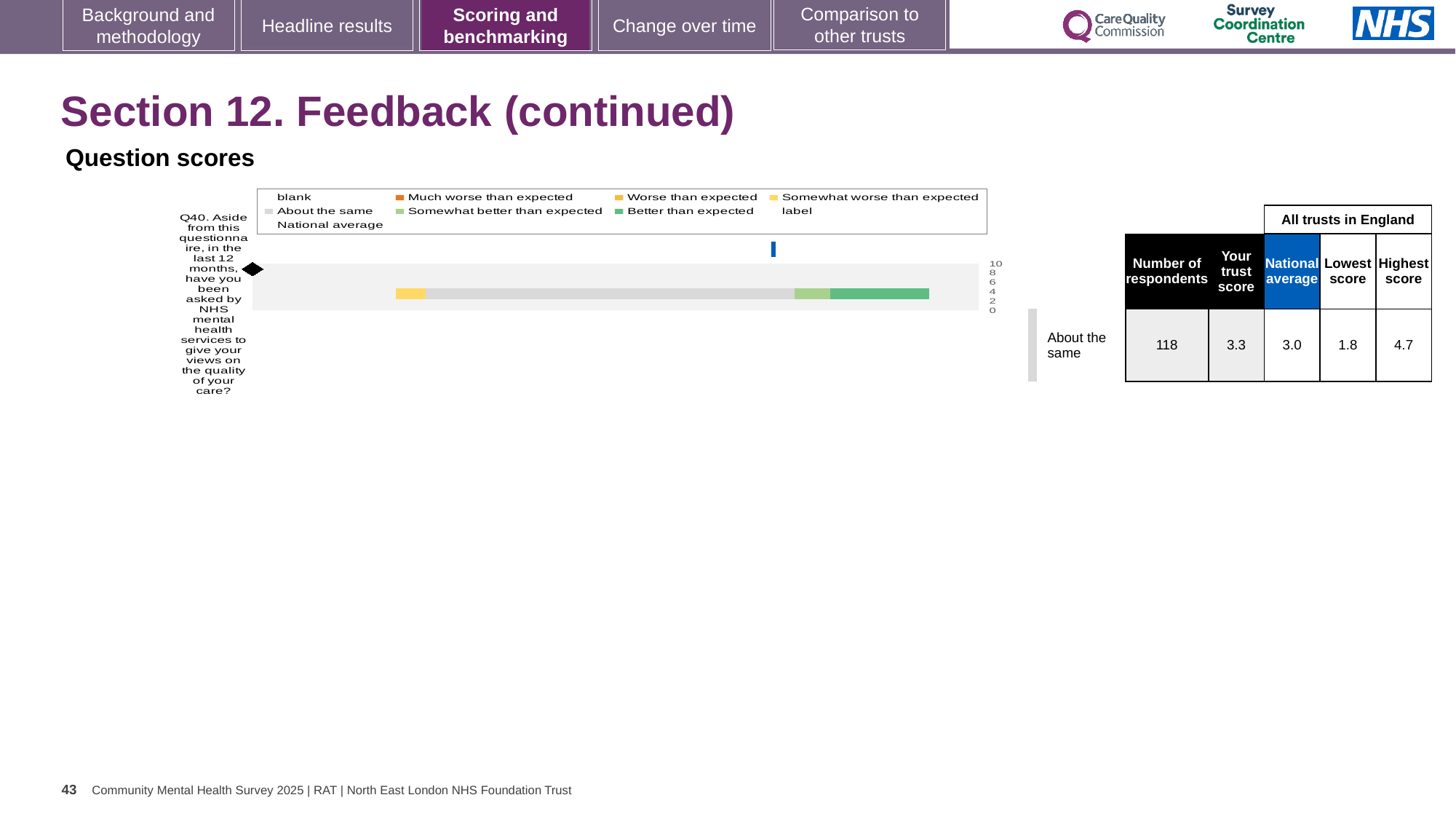
Which legend entry is shown in orange? Much worse than expected Is the trust's score for Q40 higher or lower than the national average? higher What benchmark category is shown for Q40 next to the chart? About the same In the table beside the chart, what is the national average for Q40? 3.0 How many entries does the chart legend list? 9 Which legend entry is shown in dark green? Better than expected In the table beside the chart, what is the number of respondents for Q40? 118 How many questions are plotted in the chart? 1 What kind of chart is used to show the question score for Q40? bar chart In the table beside the chart, what is the trust's score for Q40? 3.3 In the table beside the chart, what is the highest score among all trusts in England for Q40? 4.7 What is the difference between the highest score and the lowest score for Q40 in the table? 2.9